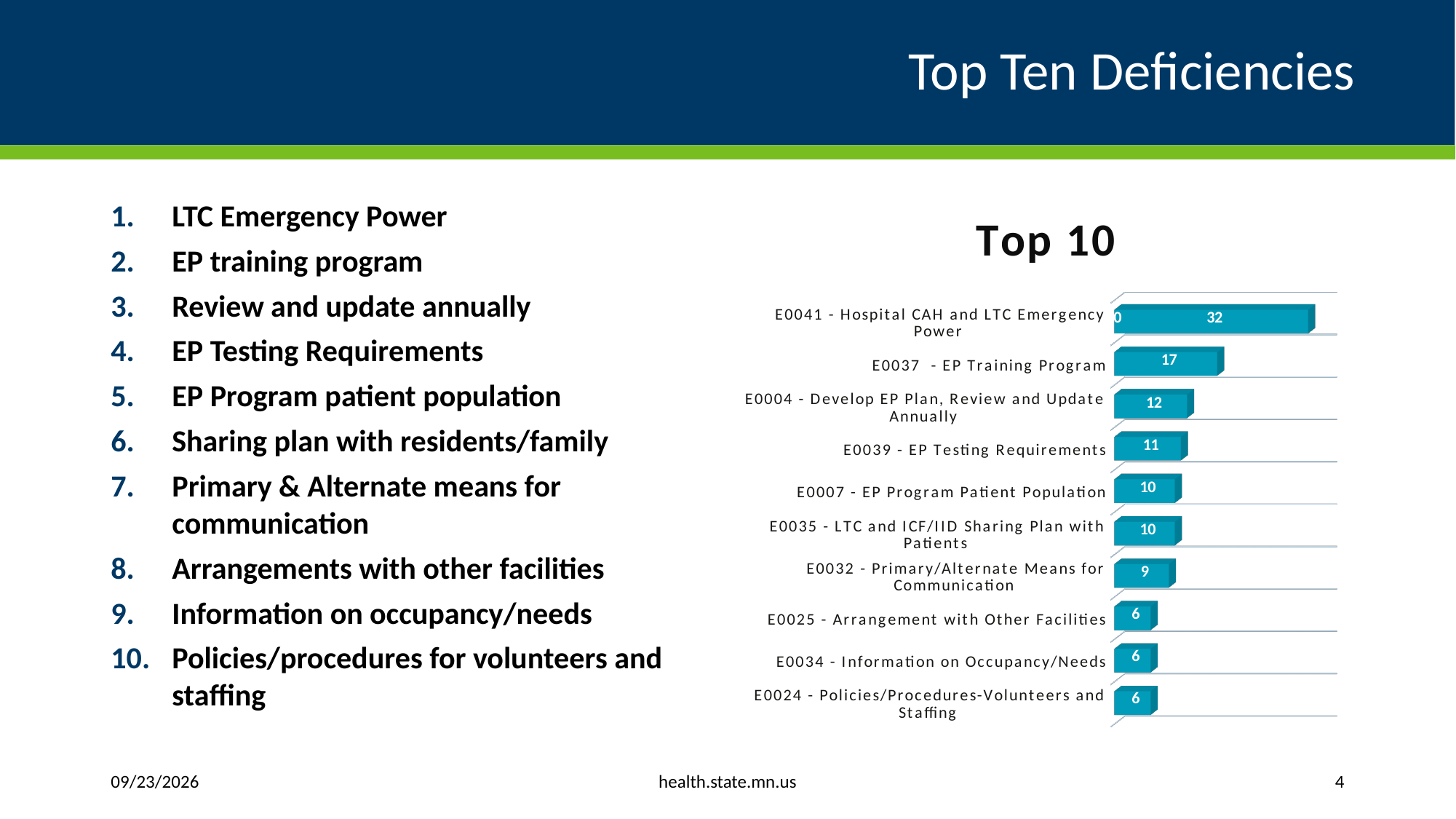
Which is larger, the value for E0007 - EP Program Patient Population or the value for E0032 - Primary/Alternate Means for Communication? E0007 - EP Program Patient Population Which category has the highest value? E0041 - Hospital CAH and LTC Emergency Power How many categories are shown in the chart? 10 What is the value for E0032 - Primary/Alternate Means for Communication? 9 What is the difference between the values for E0004 - Develop EP Plan, Review and Update Annually and E0025 - Arrangement with Other Facilities? 6 What is the value for E0037 - EP Training Program? 17 What is the value for E0039 - EP Testing Requirements? 11 What kind of chart is shown on the slide? Bar chart What is the title of the chart? Top 10 What is the value for E0041 - Hospital CAH and LTC Emergency Power? 32 What is the value for E0034 - Information on Occupancy/Needs? 6 What is the difference between the values for E0041 - Hospital CAH and LTC Emergency Power and E0037 - EP Training Program? 15